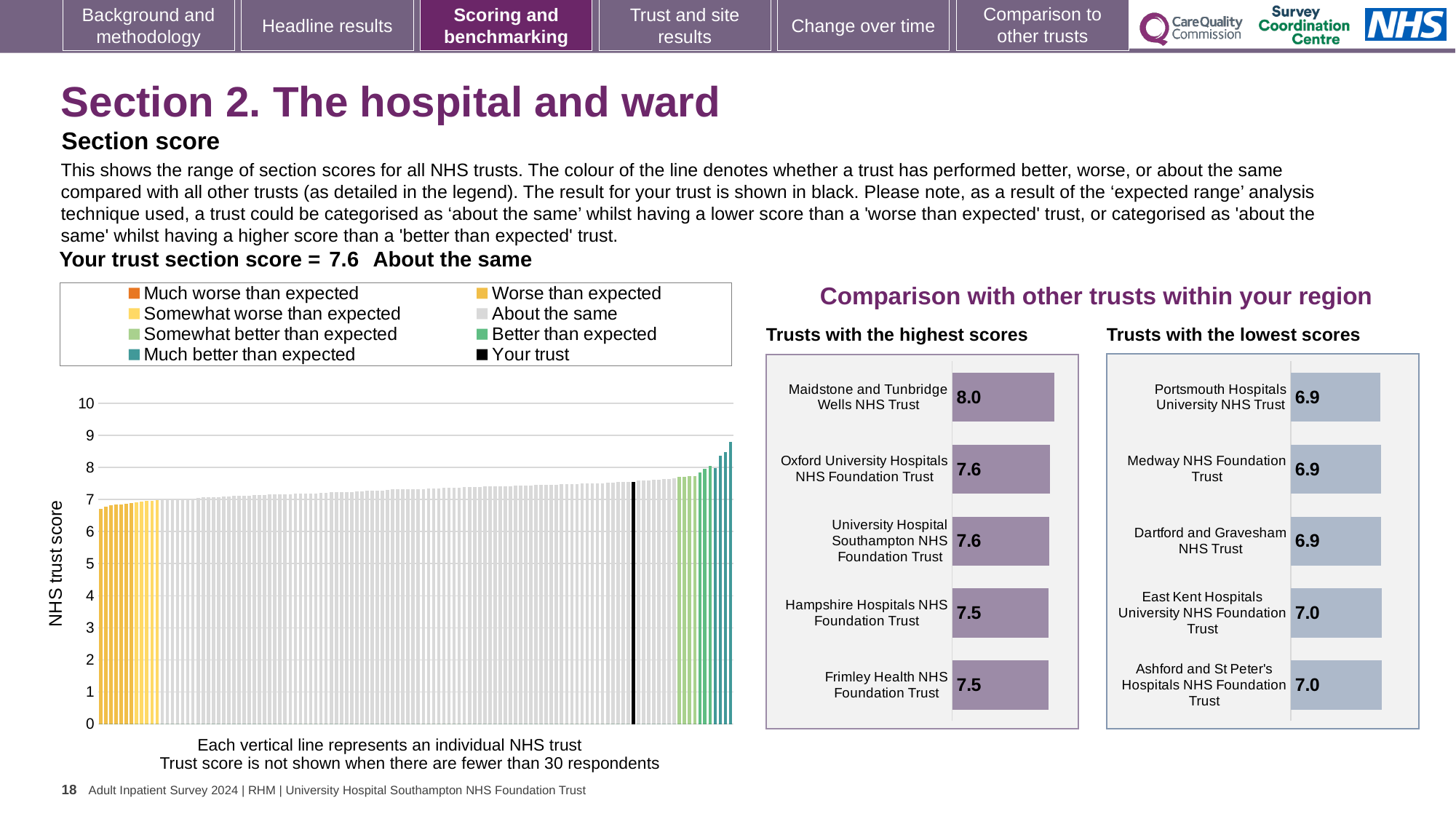
In the 'Trusts with the highest scores' chart, which trust has the highest score? Maidstone and Tunbridge Wells NHS Trust In the 'Trusts with the lowest scores' chart, what is the difference between the scores of Ashford and St Peter's Hospitals NHS Foundation Trust and Medway NHS Foundation Trust? 0.1 In the 'Trusts with the lowest scores' chart, what is the score for Dartford and Gravesham NHS Trust? 6.9 In the 'Trusts with the highest scores' chart, what is the score for Maidstone and Tunbridge Wells NHS Trust? 8.0 What kind of chart is the large chart on the left showing NHS trust scores? bar chart How many entries does the legend of the large chart on the left list? 8 In the large chart on the left, what is the section score for your trust (shown in black)? 7.6 In the large chart on the left, do the trust scores rise or fall from left to right? rise In the 'Trusts with the lowest scores' chart, which has the larger score: Ashford and St Peter's Hospitals NHS Foundation Trust or Portsmouth Hospitals University NHS Trust? Ashford and St Peter's Hospitals NHS Foundation Trust In the 'Trusts with the lowest scores' chart, what is the score for East Kent Hospitals University NHS Foundation Trust? 7.0 In the 'Trusts with the highest scores' chart, what is the difference between the scores of Maidstone and Tunbridge Wells NHS Trust and Frimley Health NHS Foundation Trust? 0.5 How many trusts are shown in the 'Trusts with the highest scores' chart? 5